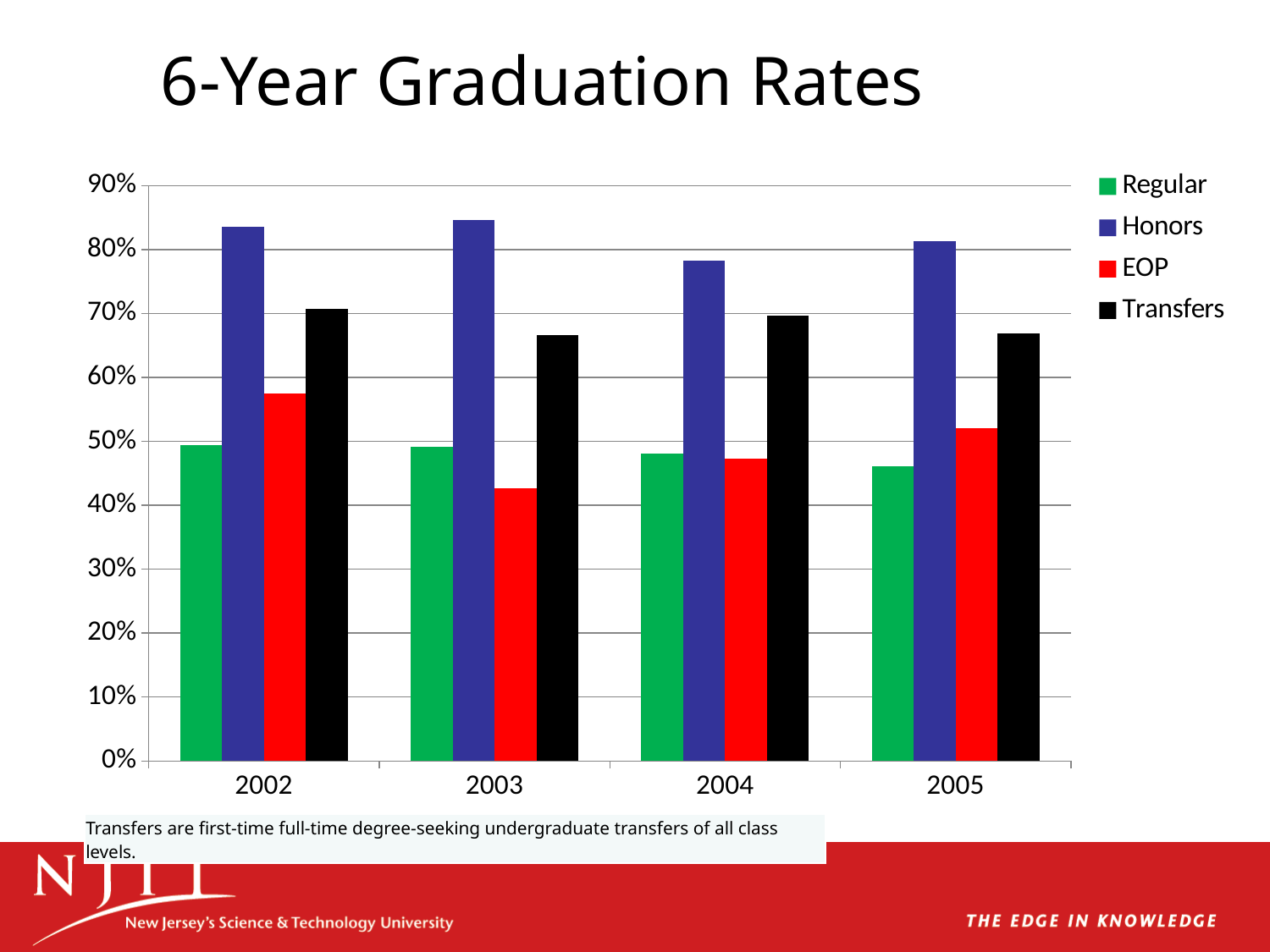
Which series is shown in black in the legend? Transfers Which series has the lowest 6-year graduation rate in 2003? EOP Is the EOP value for 2003 greater or less than 50%? less Is the Regular value for 2005 greater or less than 50%? less What kind of chart is shown on the slide? bar chart Which series has the highest 6-year graduation rate in 2004? Honors In 2002, which is larger: the EOP rate or the Regular rate? EOP How many years are shown on the x axis? 4 Is the Transfers value for 2004 greater or less than 60%? greater How many series does the legend list? 4 In which year is the Honors graduation rate lowest? 2004